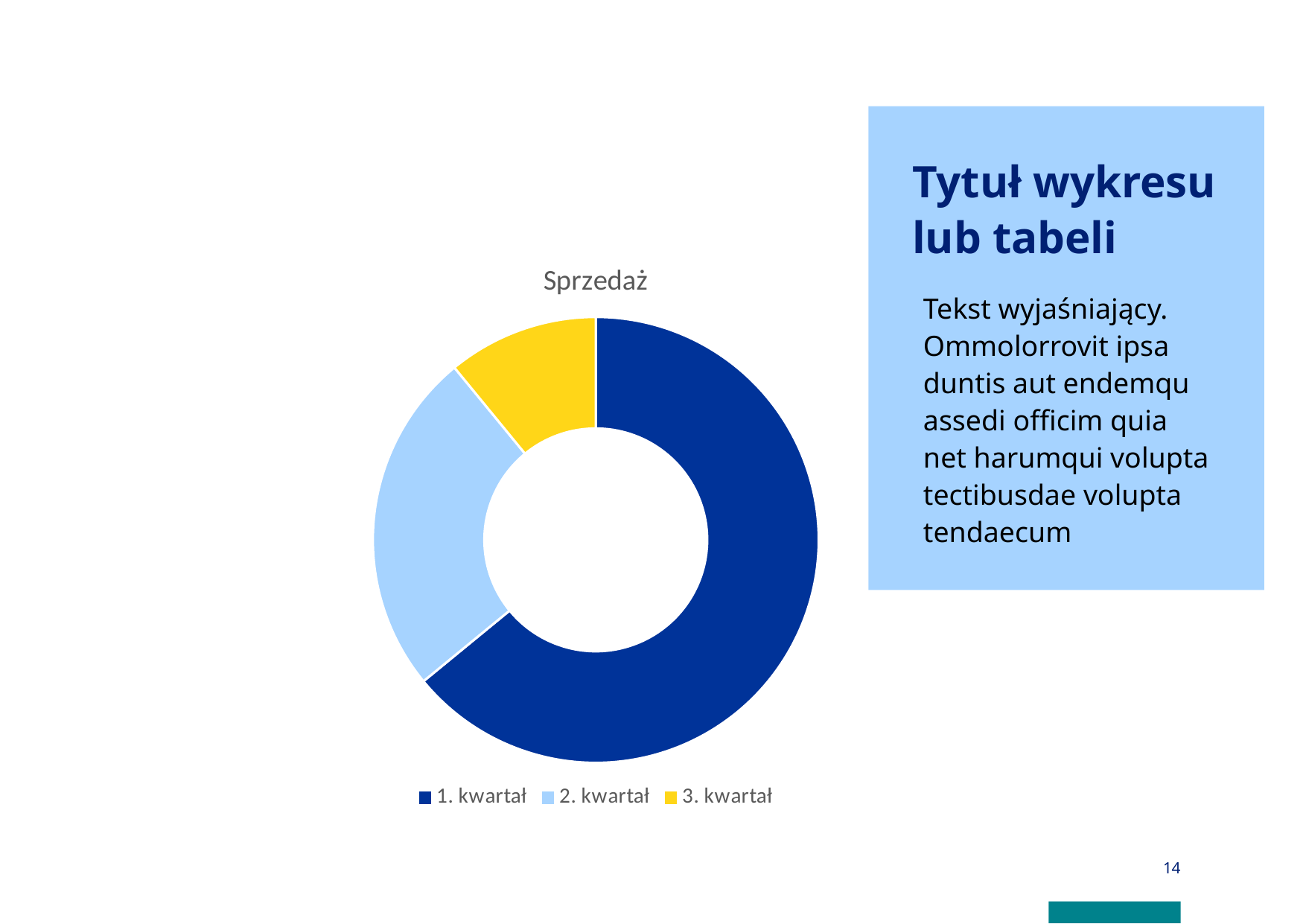
Which is larger, the slice for 2. kwartał or the slice for 3. kwartał? 2. kwartał What kind of chart is shown on the slide? Doughnut chart How many slices does the chart have? 3 Which category has the smallest slice in the chart? 3. kwartał Which is larger, the slice for 1. kwartał or the slice for 2. kwartał? 1. kwartał What colour is the slice for 3. kwartał? Yellow What is the title of the chart? Sprzedaż How many entries does the chart legend list? 3 Which category has the largest slice in the chart? 1. kwartał